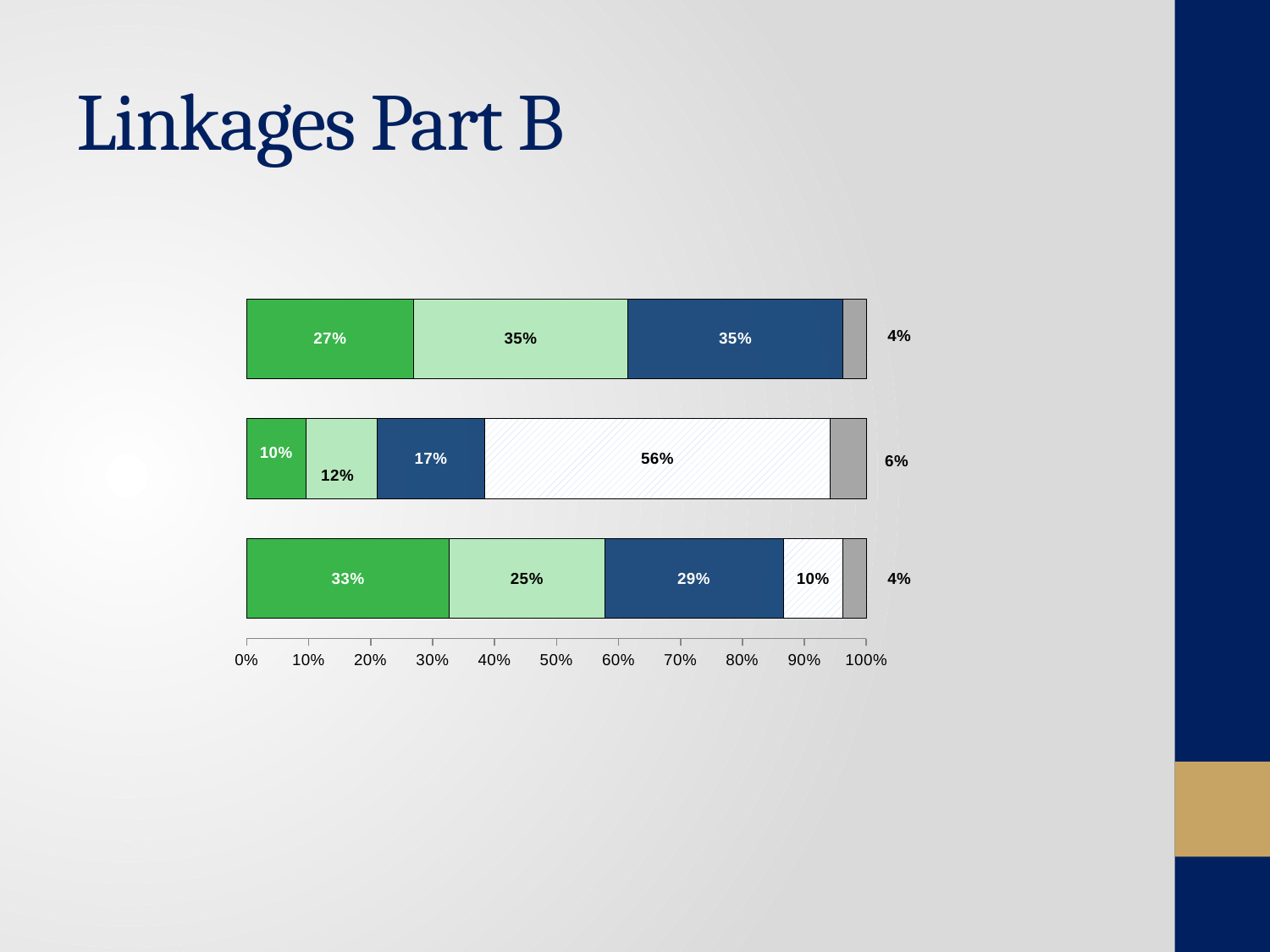
What is the value of the gray segment at the end of the middle bar? 6% What is the value of the hatched white segment in the middle bar? 56% Which bar has the largest hatched white segment? The middle bar What is the value of the dark green segment in the top bar? 27% What is the difference between the dark green segment of the bottom bar (33%) and the dark green segment of the top bar (27%)? 6% What is the title of the slide containing the chart? Linkages Part B What is the value of the dark blue segment in the bottom bar? 29% Which is larger: the dark green segment of the top bar or the dark green segment of the bottom bar? The bottom bar How many segments make up the middle bar? 5 How many bars does the chart contain? 3 What is the difference between the hatched white segment of the middle bar and the hatched white segment of the bottom bar? 46% What kind of chart is shown on the slide? Stacked bar chart